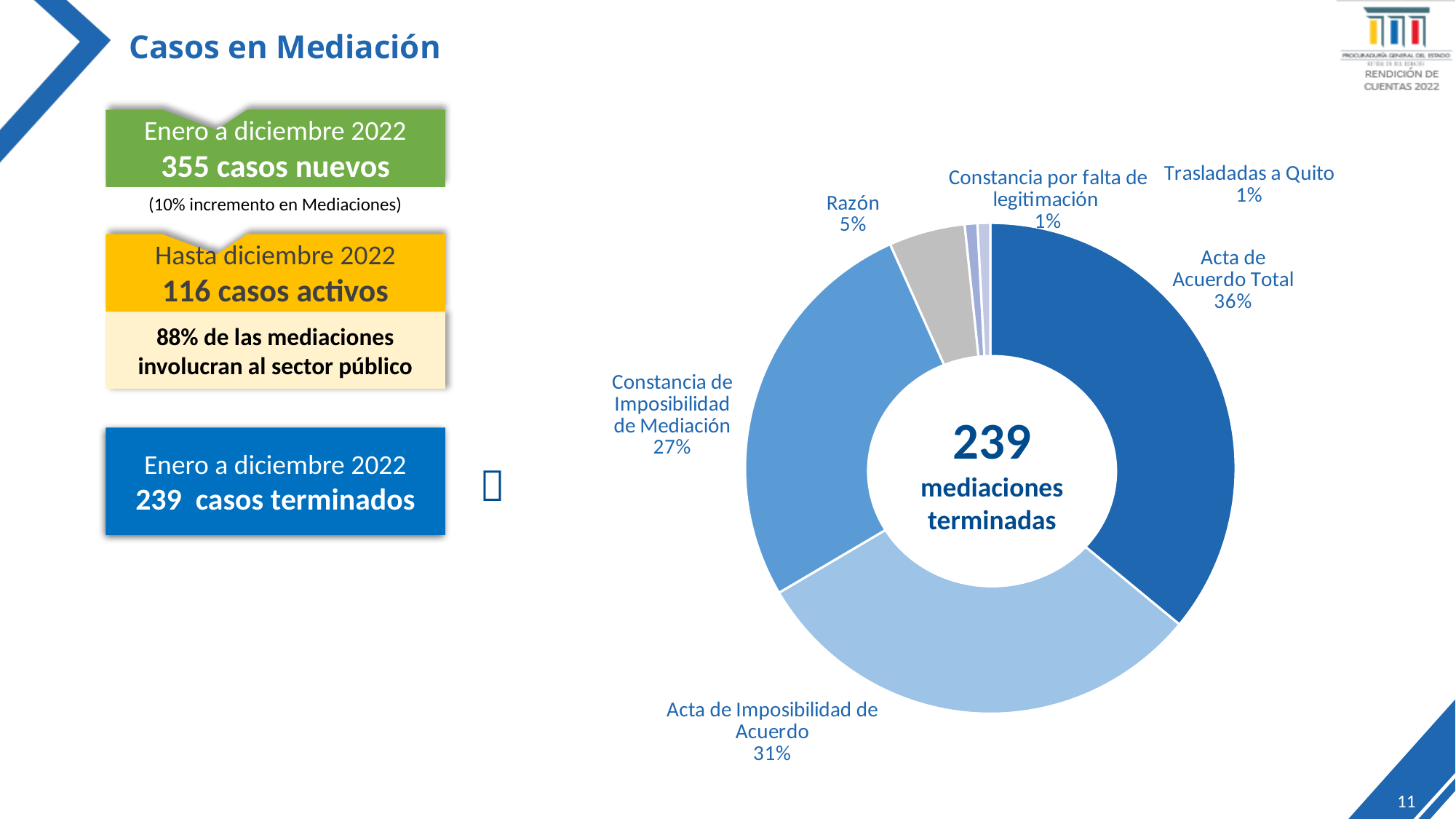
What share of the pie does Constancia de Imposibilidad de Mediación represent? 27% What number is shown in the centre of the doughnut chart? 239 What share of the pie does Acta de Imposibilidad de Acuerdo represent? 31% Which category has the largest share of the pie? Acta de Acuerdo Total What share of the pie does Razón represent? 5% What text appears in the centre of the doughnut chart below the number? mediaciones terminadas What kind of chart is shown on the slide? Pie chart (doughnut) Which is larger: the share for Acta de Imposibilidad de Acuerdo or the share for Razón? Acta de Imposibilidad de Acuerdo How many categories are shown in the pie chart? 6 What is the difference in percentage points between Acta de Acuerdo Total and Constancia de Imposibilidad de Mediación? 9 percentage points